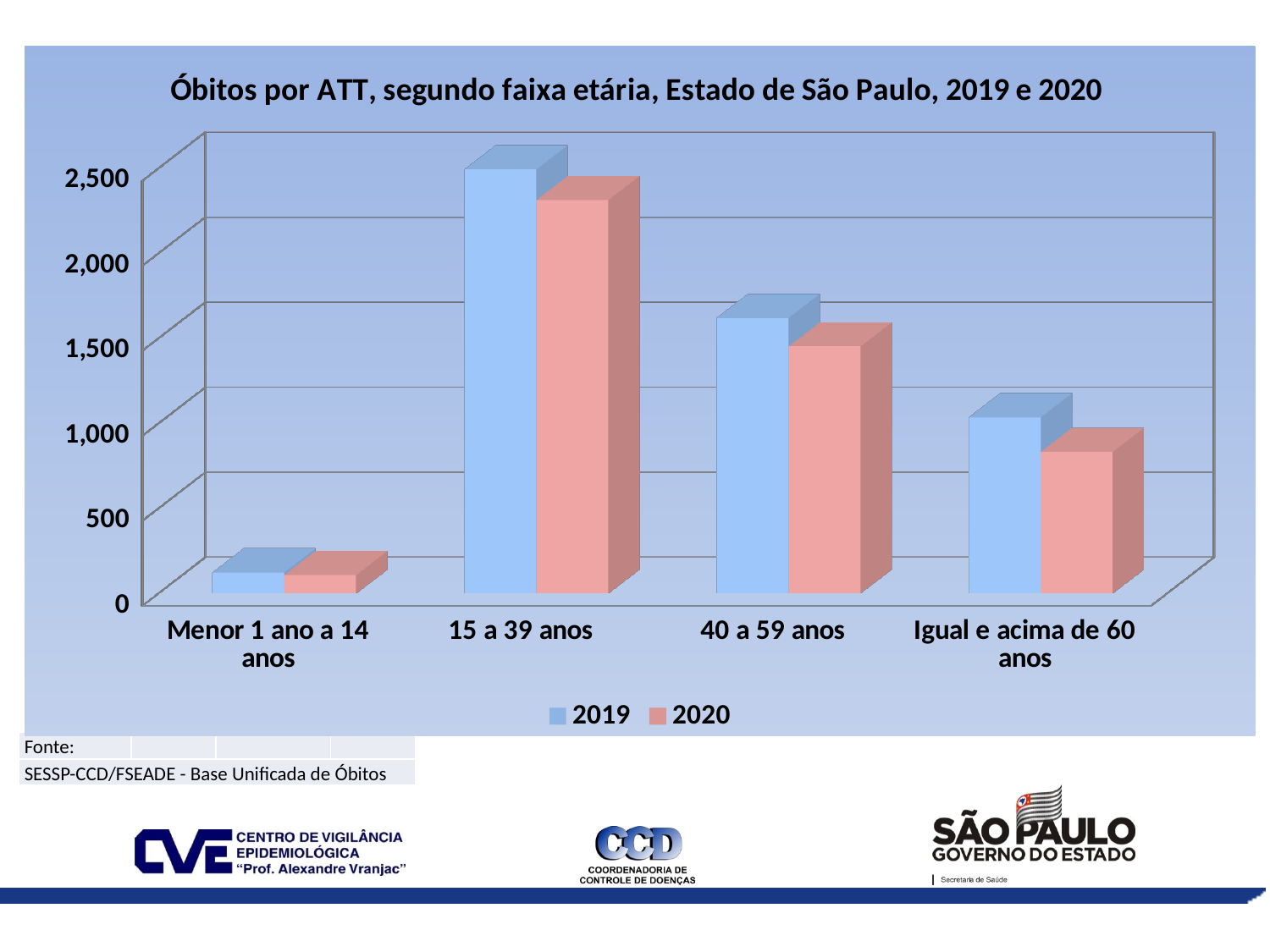
Which age group has the lowest number of deaths in 2020? Menor 1 ano a 14 anos For the 40 a 59 anos group, which year has the larger value, 2019 or 2020? 2019 How many age-group categories are shown on the x axis? 4 What type of chart is shown on the slide? bar chart How many series does the legend list? 2 For the Igual e acima de 60 anos group, which year has the larger value, 2019 or 2020? 2019 What is the title of the chart? Óbitos por ATT, segundo faixa etária, Estado de São Paulo, 2019 e 2020 Which age group has the highest number of deaths in 2019? 15 a 39 anos Is the 2019 value for Menor 1 ano a 14 anos greater or less than 500? less Is the 2020 value for Igual e acima de 60 anos greater or less than 1,000? less Is the 2020 value for 15 a 39 anos greater or less than 2,000? greater